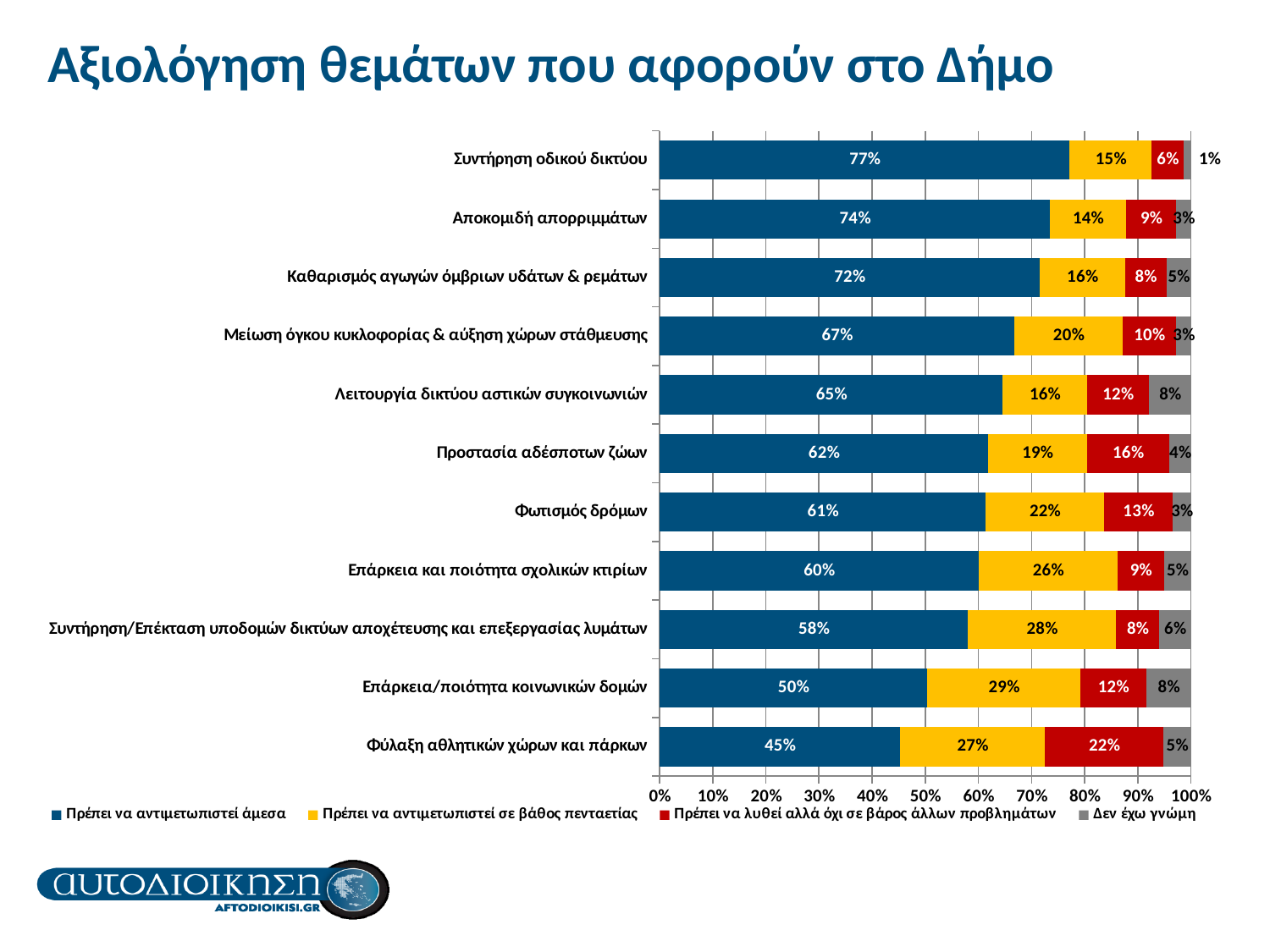
Which category has the highest 'Πρέπει να αντιμετωπιστεί άμεσα' value? Συντήρηση οδικού δικτύου What percentage of respondents said 'Πρέπει να αντιμετωπιστεί άμεσα' for 'Συντήρηση οδικού δικτύου'? 77% Is the 'Πρέπει να αντιμετωπιστεί άμεσα' value for 'Λειτουργία δικτύου αστικών συγκοινωνιών' greater or less than 60%? greater What is the 'Πρέπει να λυθεί αλλά όχι σε βάρος άλλων προβλημάτων' value for 'Φύλαξη αθλητικών χώρων και πάρκων'? 22% What is the value of 'Πρέπει να αντιμετωπιστεί σε βάθος πενταετίας' for 'Επάρκεια/ποιότητα κοινωνικών δομών'? 29% Which category has the lowest 'Πρέπει να αντιμετωπιστεί άμεσα' value? Φύλαξη αθλητικών χώρων και πάρκων Which has a larger 'Πρέπει να αντιμετωπιστεί σε βάθος πενταετίας' value: 'Επάρκεια και ποιότητα σχολικών κτιρίων' or 'Προστασία αδέσποτων ζώων'? Επάρκεια και ποιότητα σχολικών κτιρίων What is the difference between the 'Πρέπει να αντιμετωπιστεί άμεσα' values for 'Αποκομιδή απορριμμάτων' and 'Φωτισμός δρόμων'? 13% What is the title of the slide? Αξιολόγηση θεμάτων που αφορούν στο Δήμο How many categories are shown in the chart? 11 What kind of chart is shown on the slide? Stacked bar chart How many series does the legend list? 4